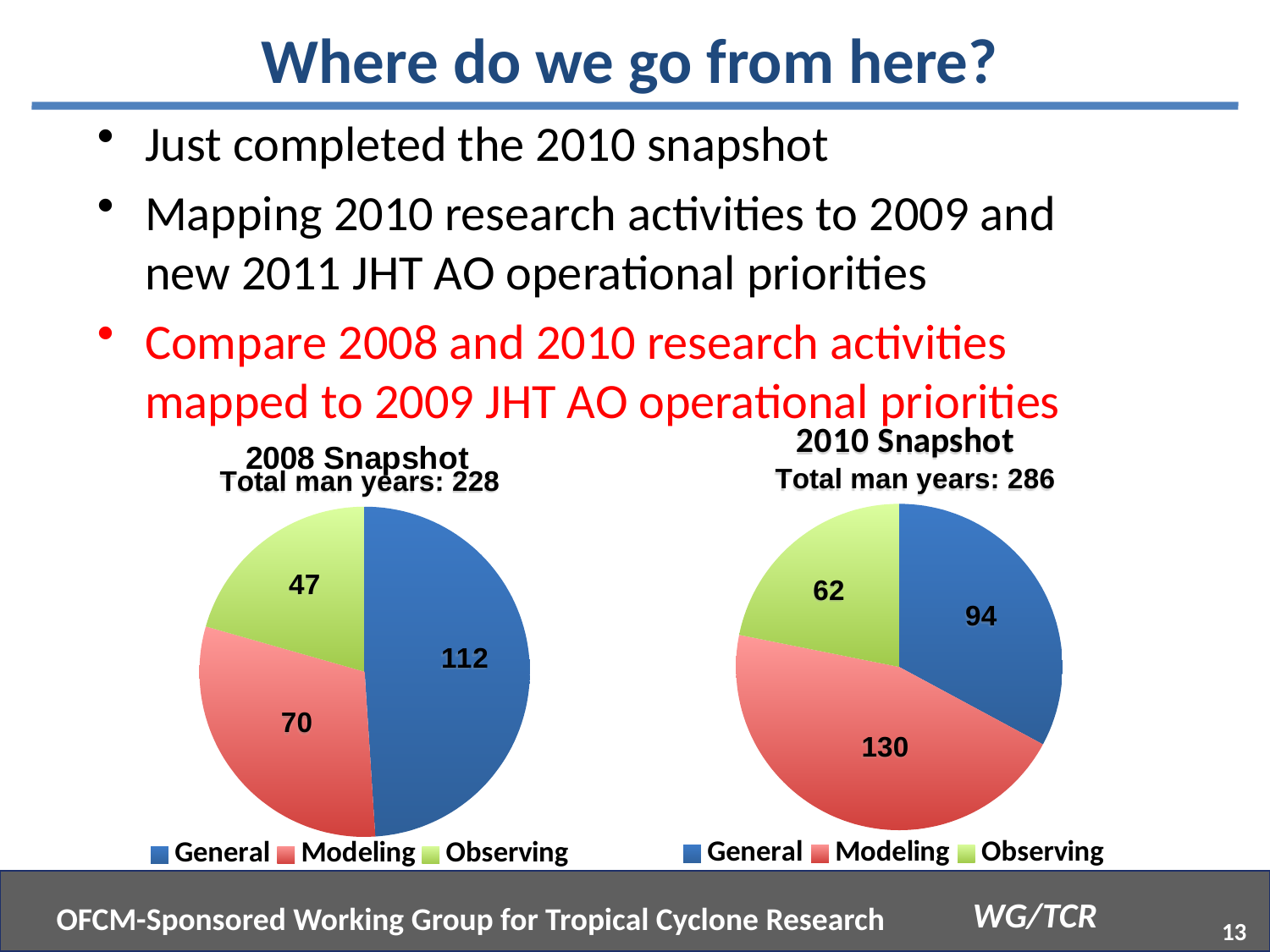
In the 2010 Snapshot pie chart, which category has the largest slice? Modeling In the 2010 Snapshot pie chart, what is the value for Observing? 62 In the 2010 Snapshot pie chart, which category has the smallest slice? Observing What total man years does the 2010 Snapshot chart title state? 286 Is the Modeling value larger in the 2008 Snapshot chart or the 2010 Snapshot chart? 2010 Snapshot In the 2010 Snapshot pie chart, what is the difference between Modeling and General? 36 How many slices does the 2008 Snapshot pie chart have? 3 In the 2008 Snapshot pie chart, which category has the largest slice? General In the 2008 Snapshot pie chart, what is the difference between General and Modeling? 42 In the 2010 Snapshot pie chart, what is the value for General? 94 In the 2008 Snapshot pie chart, what is the value for Modeling? 70 What kind of chart is the 2010 Snapshot chart? Pie chart